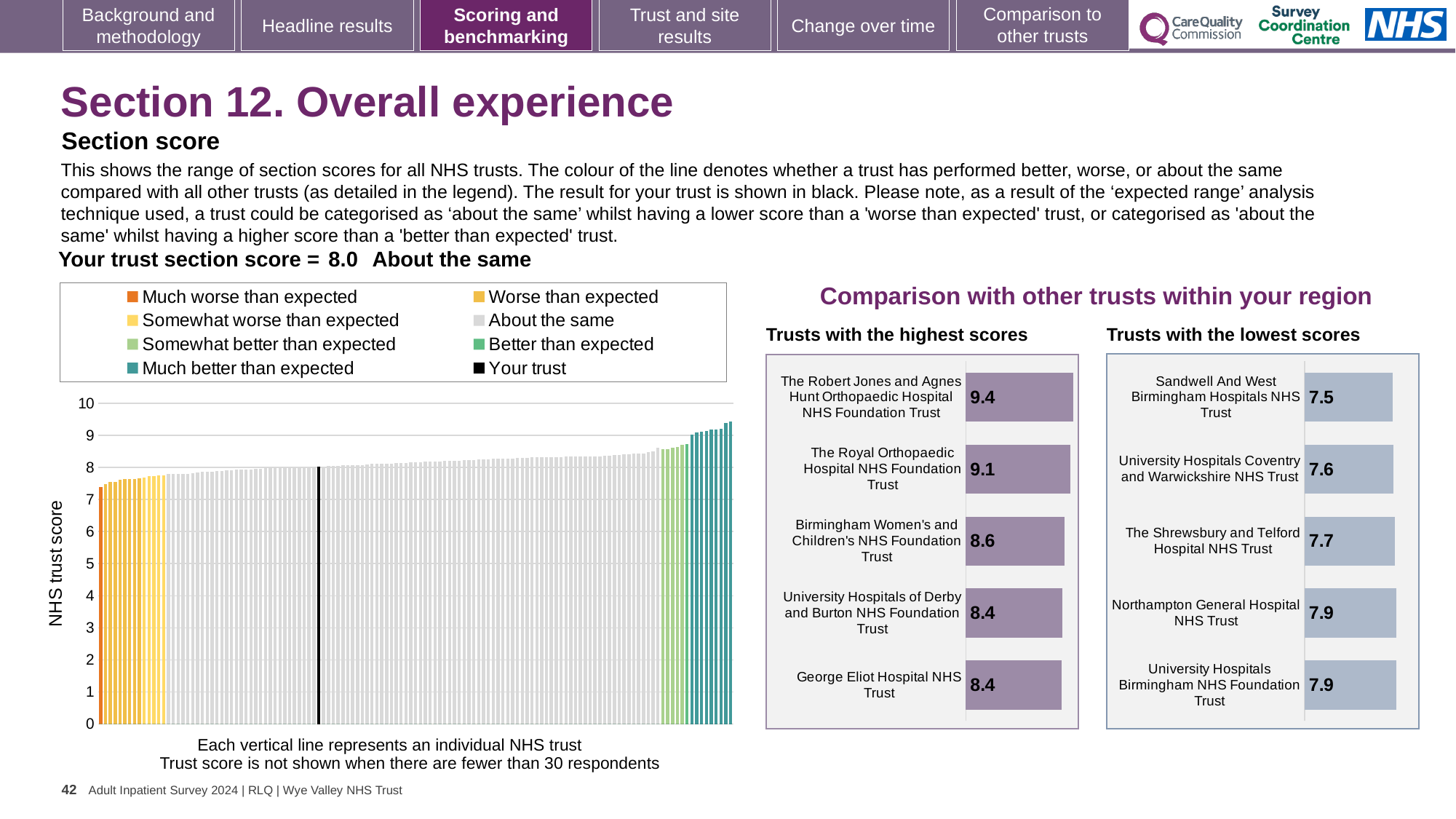
In the main NHS trust score chart, do the values rise or fall from left to right? Rise In the 'Trusts with the highest scores' chart, what is the score for The Robert Jones and Agnes Hunt Orthopaedic Hospital NHS Foundation Trust? 9.4 What is the section score for your trust shown on the slide? 8.0 What kind of chart is the main chart on the left showing NHS trust scores? Bar chart In the 'Trusts with the lowest scores' chart, what is the score for Sandwell And West Birmingham Hospitals NHS Trust? 7.5 How many trusts are shown in the 'Trusts with the highest scores' chart? 5 In the 'Trusts with the lowest scores' chart, what is the difference between the scores of Northampton General Hospital NHS Trust and Sandwell And West Birmingham Hospitals NHS Trust? 0.4 In the 'Trusts with the highest scores' chart, which trust has the highest score? The Robert Jones and Agnes Hunt Orthopaedic Hospital NHS Foundation Trust In the 'Trusts with the highest scores' chart, what is the difference between the scores of The Robert Jones and Agnes Hunt Orthopaedic Hospital NHS Foundation Trust and The Royal Orthopaedic Hospital NHS Foundation Trust? 0.3 Which has the higher score: Birmingham Women's and Children's NHS Foundation Trust in the highest scores chart, or University Hospitals Coventry and Warwickshire NHS Trust in the lowest scores chart? Birmingham Women's and Children's NHS Foundation Trust How many entries does the legend of the main NHS trust score chart list? 8 In the 'Trusts with the lowest scores' chart, which trust has the lowest score? Sandwell And West Birmingham Hospitals NHS Trust